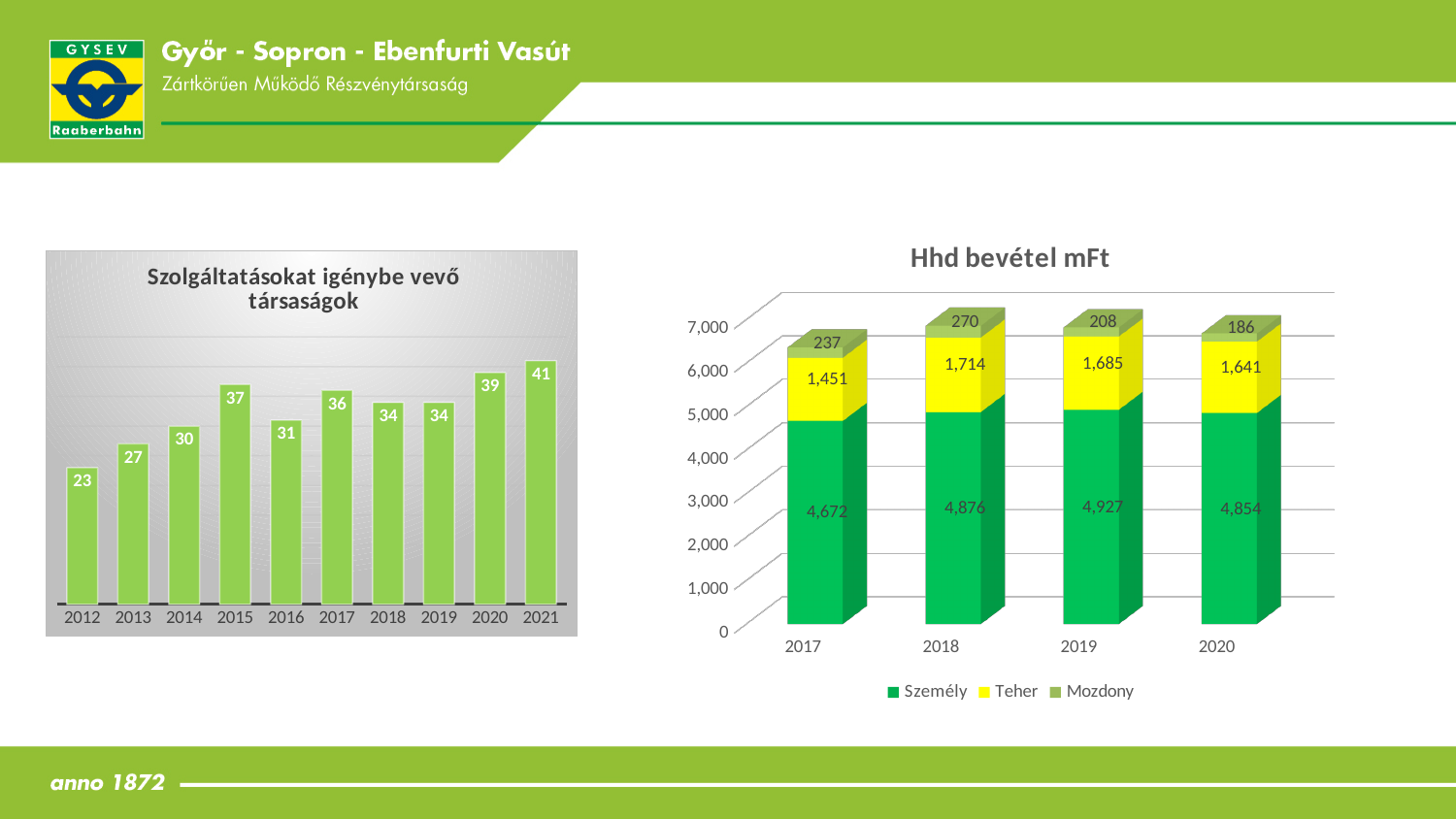
In the 'Hhd bevétel mFt' chart, what is the Teher value for 2018? 1,714 In the 'Szolgáltatásokat igénybe vevő társaságok' chart, what is the difference between the values for 2021 and 2012? 18 In the 'Hhd bevétel mFt' chart, which year has the highest Személy value? 2019 In the 'Hhd bevétel mFt' chart, what is the Mozdony value for 2020? 186 How many series does the legend of the 'Hhd bevétel mFt' chart list? 3 What kind of chart is the 'Hhd bevétel mFt' chart? stacked bar chart In the 'Hhd bevétel mFt' chart, what is the total of the stacked bar for 2017? 6,360 How many years are shown on the x axis of the 'Szolgáltatásokat igénybe vevő társaságok' chart? 10 In the 'Szolgáltatásokat igénybe vevő társaságok' chart, what is the value for 2015? 37 In the 'Hhd bevétel mFt' chart, is the Személy value for 2018 larger or smaller than the Személy value for 2020? larger In the 'Szolgáltatásokat igénybe vevő társaságok' chart, which year has the lowest value? 2012 In the 'Szolgáltatásokat igénybe vevő társaságok' chart, which year has the highest value? 2021